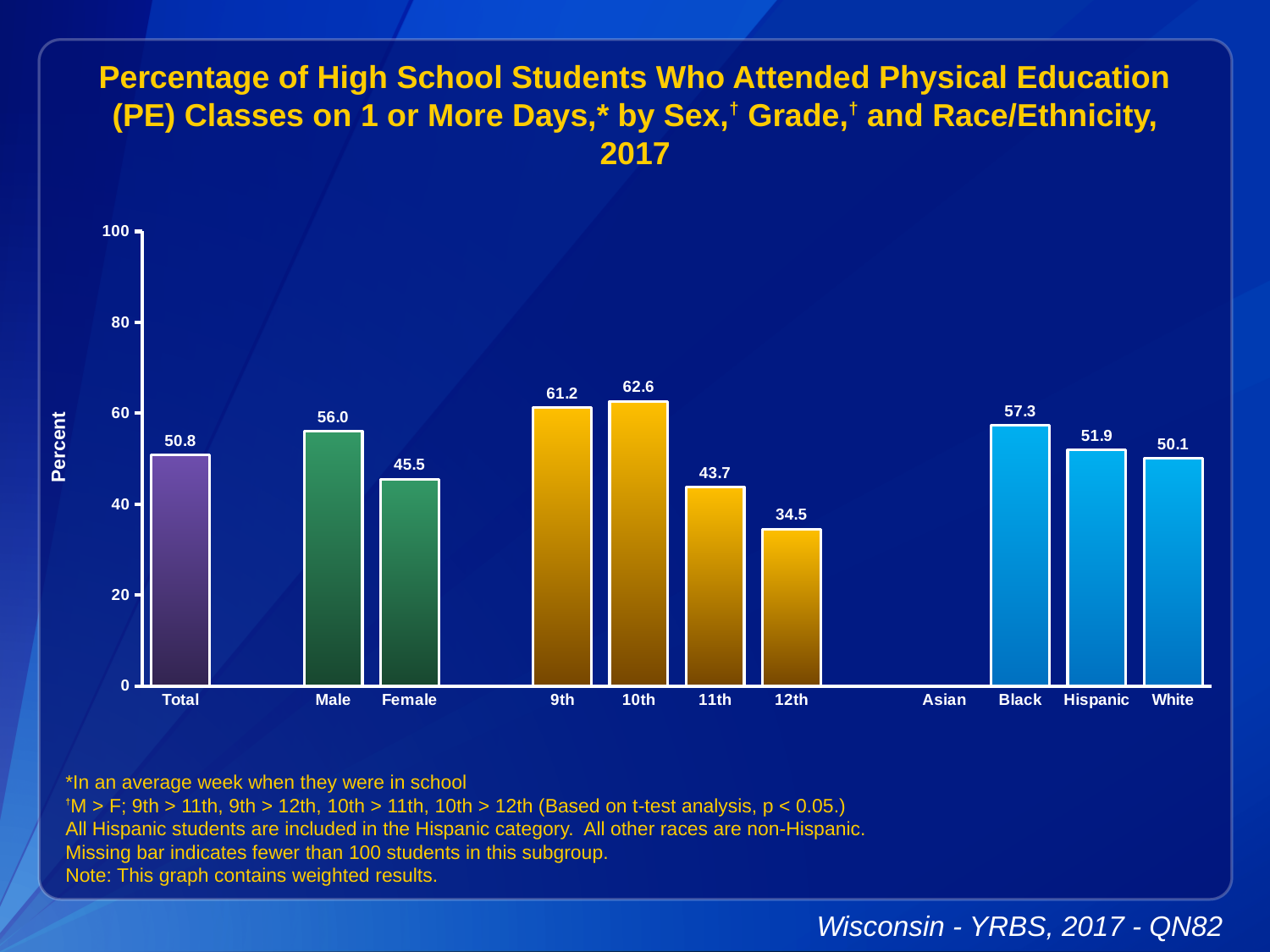
What kind of chart is shown? bar chart Which category has the lowest value among those with a bar? 12th What is the value for Female? 45.5 What is the value for Total? 50.8 Which category has the highest value? 10th What is the value for 12th grade? 34.5 Which category label has no bar shown? Asian How many categories have a bar plotted? 10 Is the value for 9th grade greater or less than 60? greater What is the value for Hispanic? 51.9 Which is larger, the value for Black or the value for White? Black What is the difference between the Male and Female values? 10.5